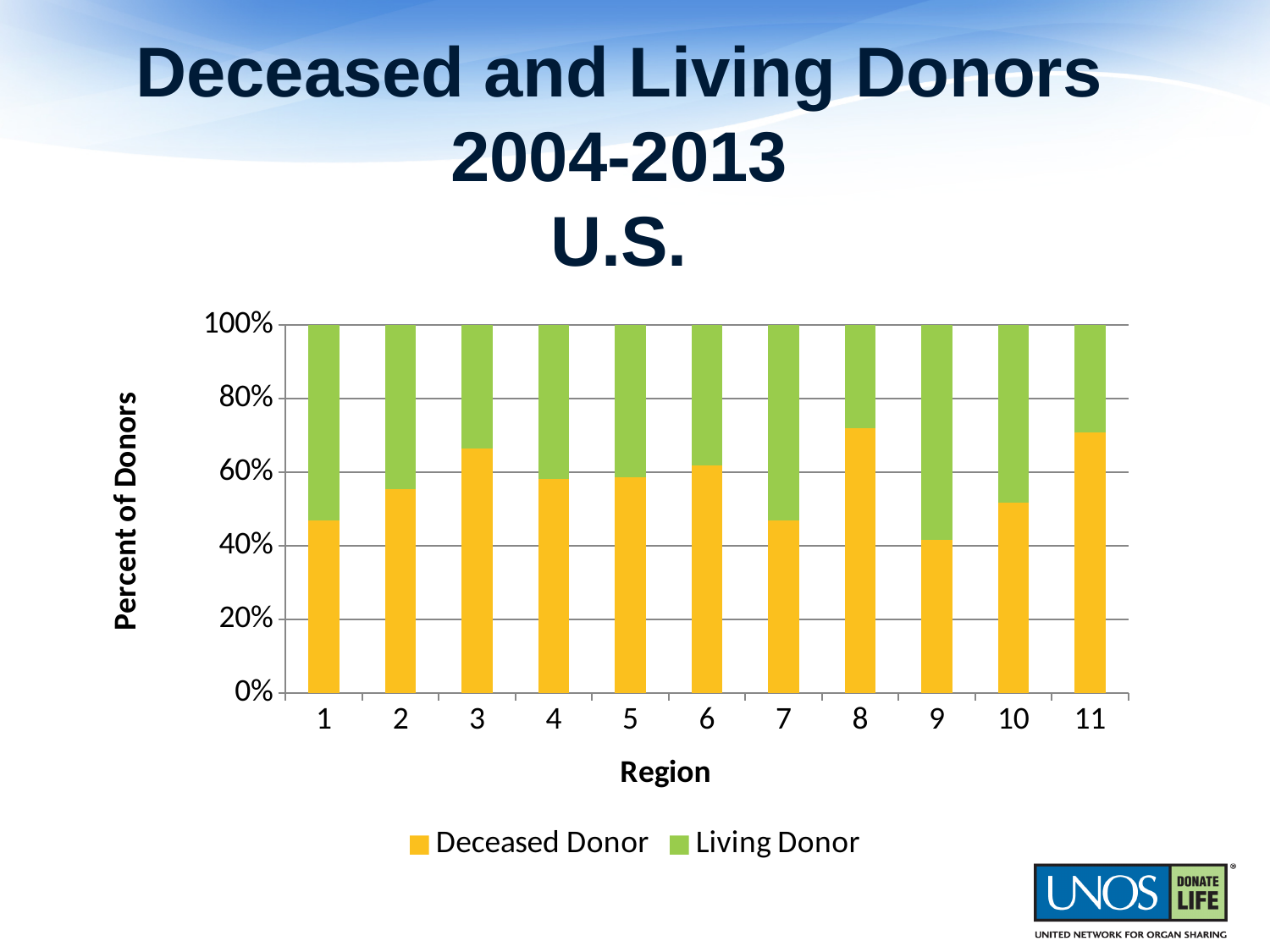
Which region has a larger Deceased Donor percentage, Region 3 or Region 1? Region 3 Which region has the lowest Deceased Donor percentage? Region 9 Is the Deceased Donor value for Region 1 greater or less than 50%? less How many regions are shown on the x axis of the chart? 11 Is the Deceased Donor value for Region 3 greater or less than 60%? greater Which region has the highest Living Donor percentage? Region 9 Is the Deceased Donor value for Region 8 greater or less than 60%? greater What kind of chart is shown on the slide? Stacked bar chart What is the label of the y axis? Percent of Donors Which series is shown in green in the chart? Living Donor How many series does the chart legend list? 2